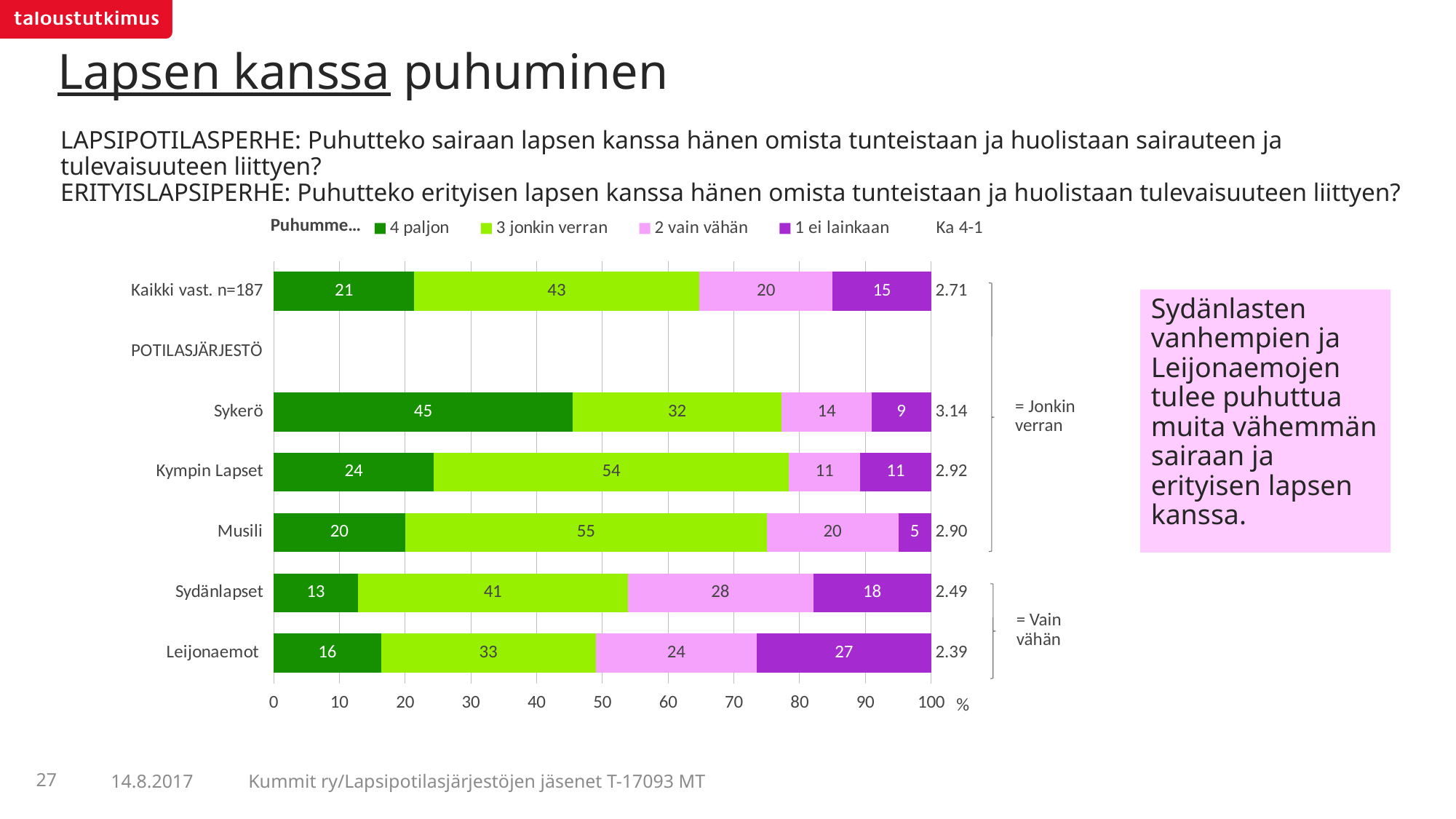
Which category has the highest Ka 4-1 value? Sykerö How many series does the chart legend list? 5 What is the total of the '4 paljon' and '3 jonkin verran' values for Leijonaemot? 49 Which is larger: the '3 jonkin verran' value for Kympin Lapset or for Kaikki vast. n=187? Kympin Lapset What is the value of '1 ei lainkaan' for Leijonaemot? 27 What is the Ka 4-1 value shown for Sydänlapset? 2.49 What kind of chart is shown on the slide? Stacked bar chart What is the difference between the '2 vain vähän' values for Sydänlapset and Kympin Lapset? 17 Which category has the highest value for '4 paljon'? Sykerö Which category has the lowest value for '1 ei lainkaan'? Musili What is the value of '3 jonkin verran' for Musili? 55 What is the value of '4 paljon' for Sykerö? 45